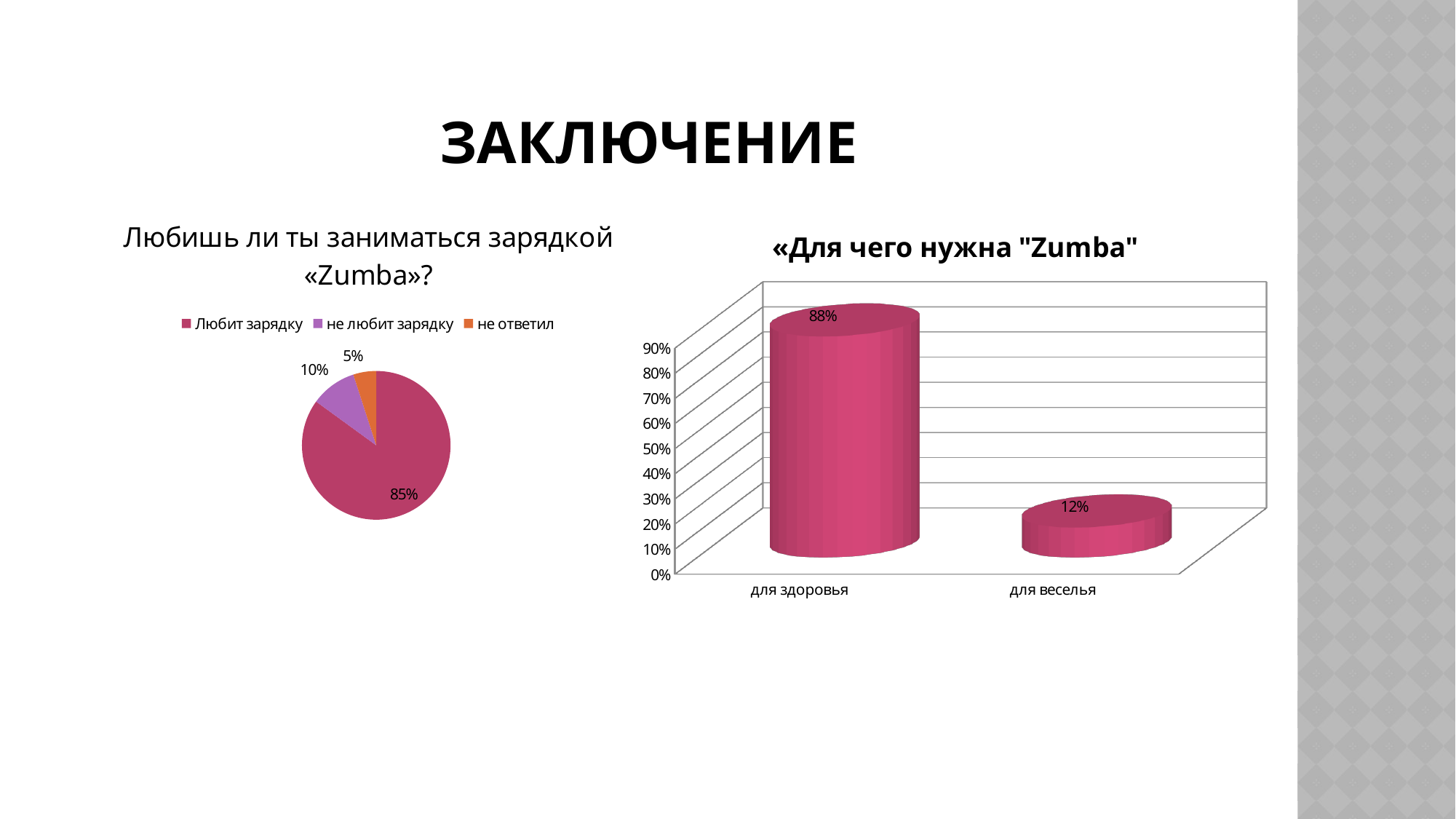
In the chart «Для чего нужна "Zumba"», how many categories are shown on the x axis? 2 In the pie chart «Любишь ли ты заниматься зарядкой «Zumba»?», which category has the largest slice? Любит зарядку In the pie chart «Любишь ли ты заниматься зарядкой «Zumba»?», what share is labelled for «не ответил»? 5% In the pie chart «Любишь ли ты заниматься зарядкой «Zumba»?», what share is labelled for «не любит зарядку»? 10% In the pie chart «Любишь ли ты заниматься зарядкой «Zumba»?», what share is labelled for «Любит зарядку»? 85% In the chart «Для чего нужна "Zumba"», what is the difference between «для здоровья» and «для веселья»? 76% In the pie chart «Любишь ли ты заниматься зарядкой «Zumba»?», what is the difference between the shares for «Любит зарядку» and «не любит зарядку»? 75% In the pie chart «Любишь ли ты заниматься зарядкой «Zumba»?», which category has the smallest slice? не ответил What kind of chart is the chart «Для чего нужна "Zumba"»? bar chart In the chart «Для чего нужна "Zumba"», what is the value for «для веселья»? 12% In the pie chart «Любишь ли ты заниматься зарядкой «Zumba»?», how many entries does the legend list? 3 In the chart «Для чего нужна "Zumba"», what is the value for «для здоровья»? 88%